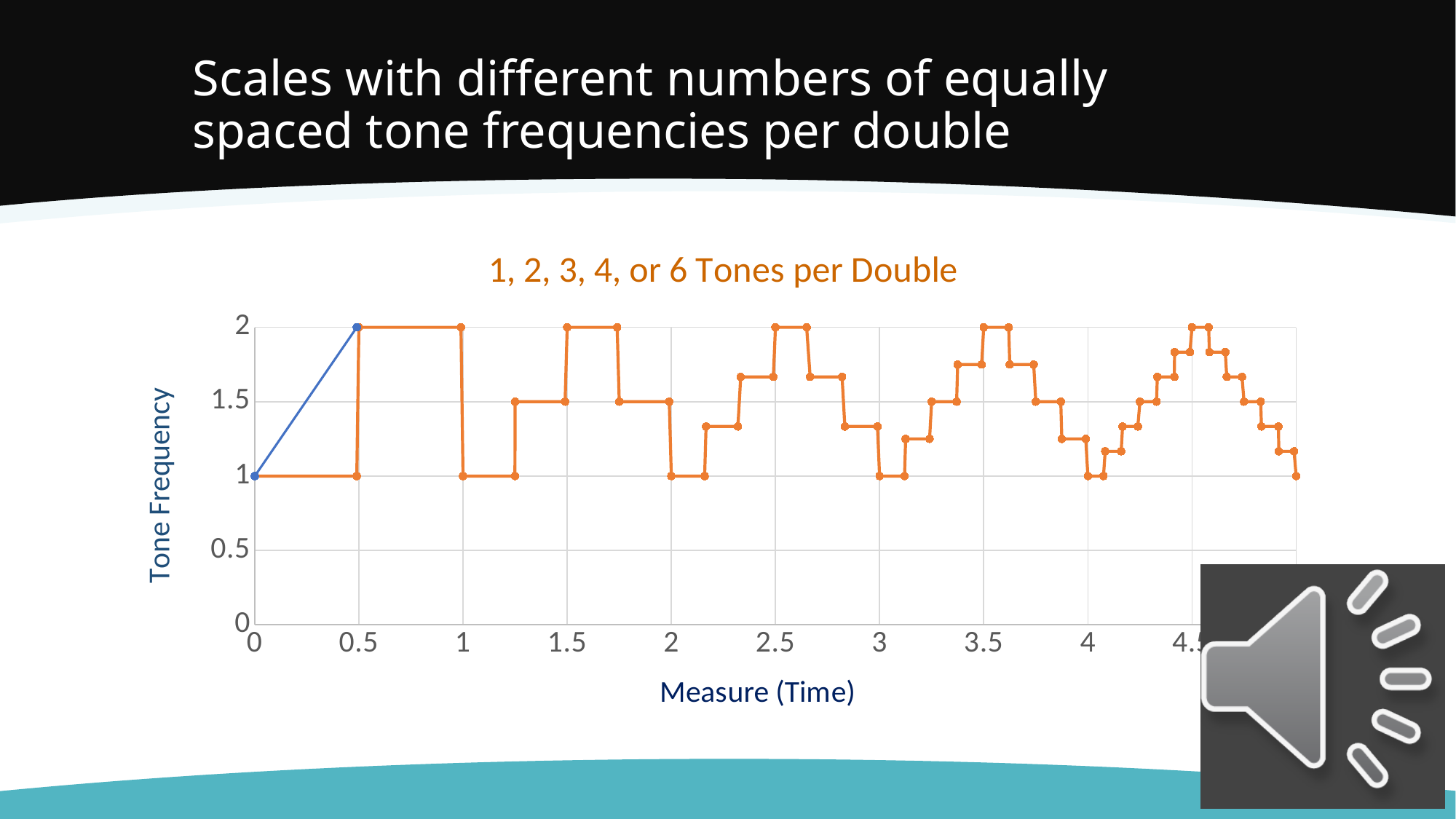
What is the title of the chart? 1, 2, 3, 4, or 6 Tones per Double Does the blue line rise or fall between Measure (Time) 0 and 0.5? rise What is the label of the vertical axis? Tone Frequency What is the Tone Frequency of the blue line at Measure (Time) 0.5? 2 Is the Tone Frequency of the orange line at Measure (Time) 3.1 greater or less than 1.5? less What is the Tone Frequency of the blue line at Measure (Time) 0? 1 Is the Tone Frequency of the orange line at Measure (Time) 1.6 greater or less than 1.5? greater Which is larger: the Tone Frequency of the orange line at Measure (Time) 0.75 or at Measure (Time) 1.1? at 0.75 What is the highest Tone Frequency value reached by the orange line? 2 What kind of chart is shown on the slide? line chart Is the Tone Frequency of the orange line at Measure (Time) 2.25 greater or less than 1.5? less What is the lowest Tone Frequency value reached by the orange line? 1